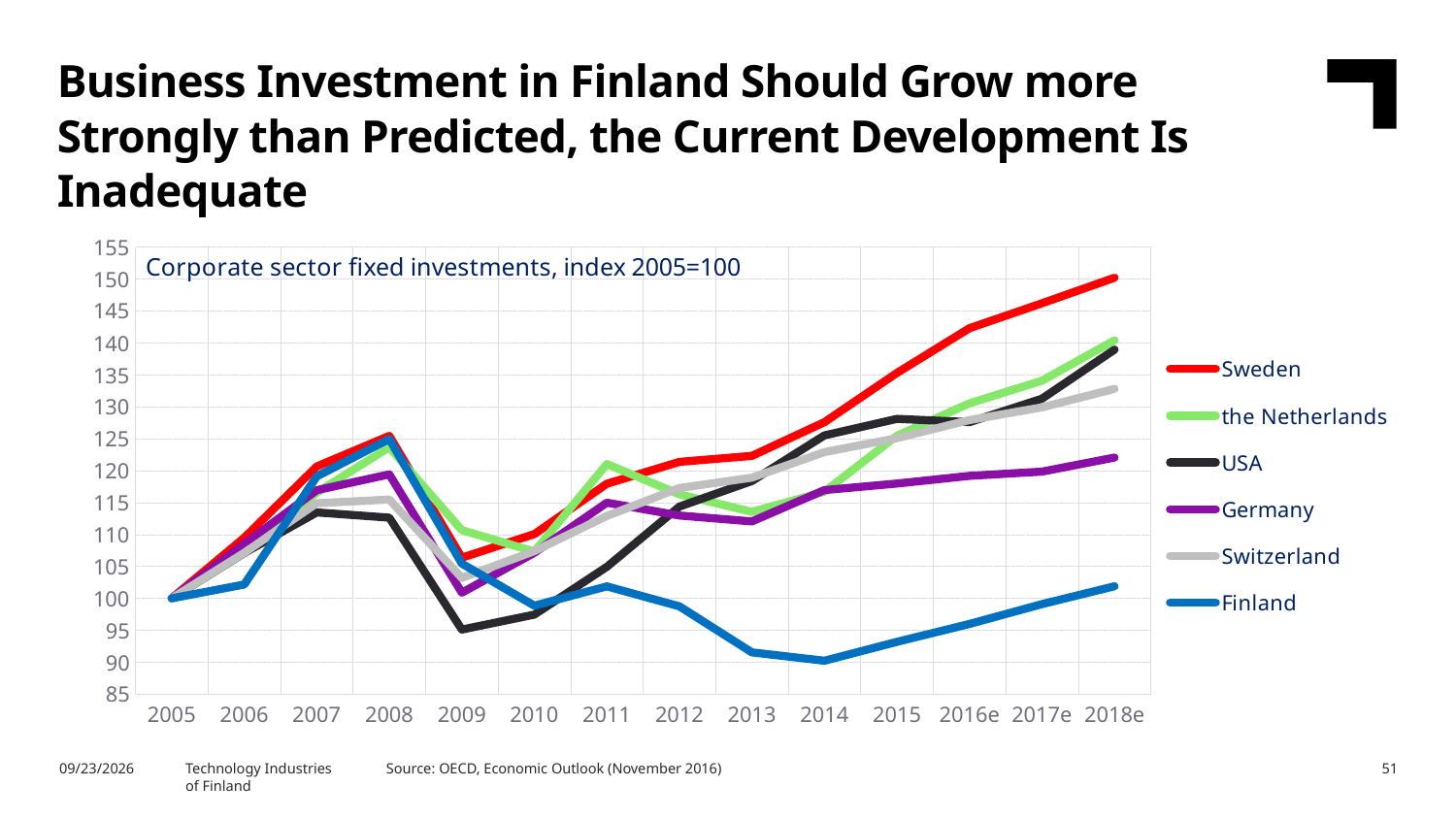
Is the value for Sweden in 2018e greater or less than 145? greater Which country has the lowest index value in 2018e? Finland Is the value for USA in 2009 greater or less than 100? less What is the index value for Finland in 2005? 100 Is the value for Finland in 2014 greater or less than 95? less What kind of chart is shown on the slide? line chart How many years are shown along the x axis? 14 Which country has the highest index value in 2018e? Sweden Which is larger in 2018e, the value for Germany or the value for Finland? Germany Does the Finland line rise or fall from 2014 to 2018e? rise What is the title shown inside the chart area? Corporate sector fixed investments, index 2005=100 How many series does the legend list? 6